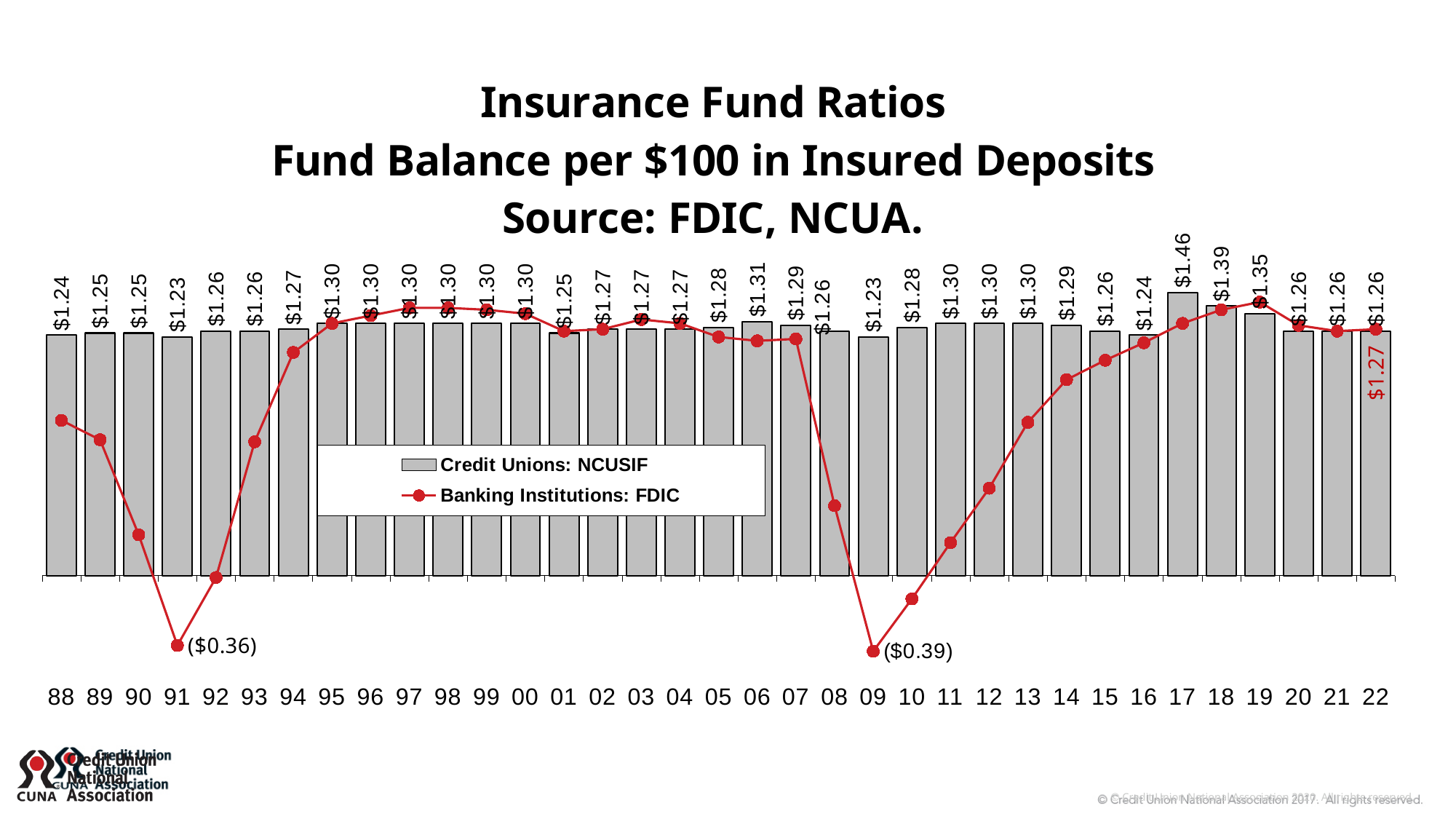
What is the Credit Unions: NCUSIF value for 17? $1.46 What kind of chart is shown on the slide? A combined bar and line chart In which year does the Banking Institutions: FDIC line reach its lowest point? 09 How many series does the legend list? 2 In which year is the Credit Unions: NCUSIF bar highest? 17 What is the difference between the Credit Unions: NCUSIF values for 17 and 18? $0.07 How many years are shown on the x axis? 35 What is the Banking Institutions: FDIC value for 22? $1.27 What are the two series named in the legend? Credit Unions: NCUSIF and Banking Institutions: FDIC What is the Banking Institutions: FDIC value for 91? ($0.36) What is the Credit Unions: NCUSIF value for 06? $1.31 What is the Banking Institutions: FDIC value for 09? ($0.39)